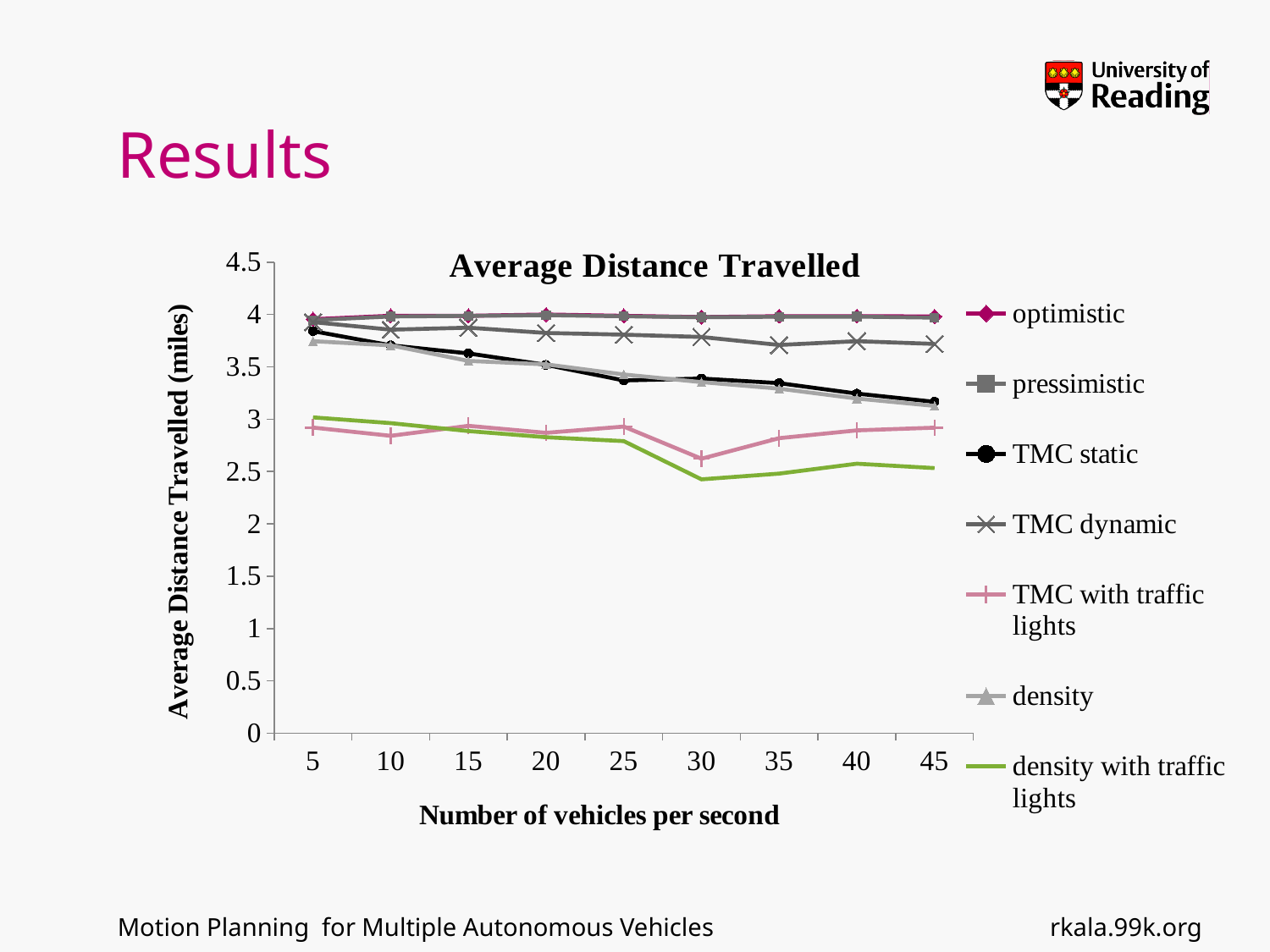
Does the 'TMC static' series rise or fall as the number of vehicles per second increases? fall What is the label of the y axis? Average Distance Travelled (miles) How many series does the legend of the chart list? 7 What is the title of the chart? Average Distance Travelled Which series has the lowest value at 45 vehicles per second? density with traffic lights How many values of 'Number of vehicles per second' are plotted along the x axis? 9 Is the value for 'TMC static' at 45 vehicles per second greater or less than 3.5? less What kind of chart is shown on the slide? line chart At 45 vehicles per second, which is larger: 'optimistic' or 'TMC static'? optimistic Does the 'density' series rise or fall as the number of vehicles per second increases? fall Is the value for 'density with traffic lights' at 30 vehicles per second greater or less than 3? less Is the value for 'optimistic' at 5 vehicles per second greater or less than 3.5? greater